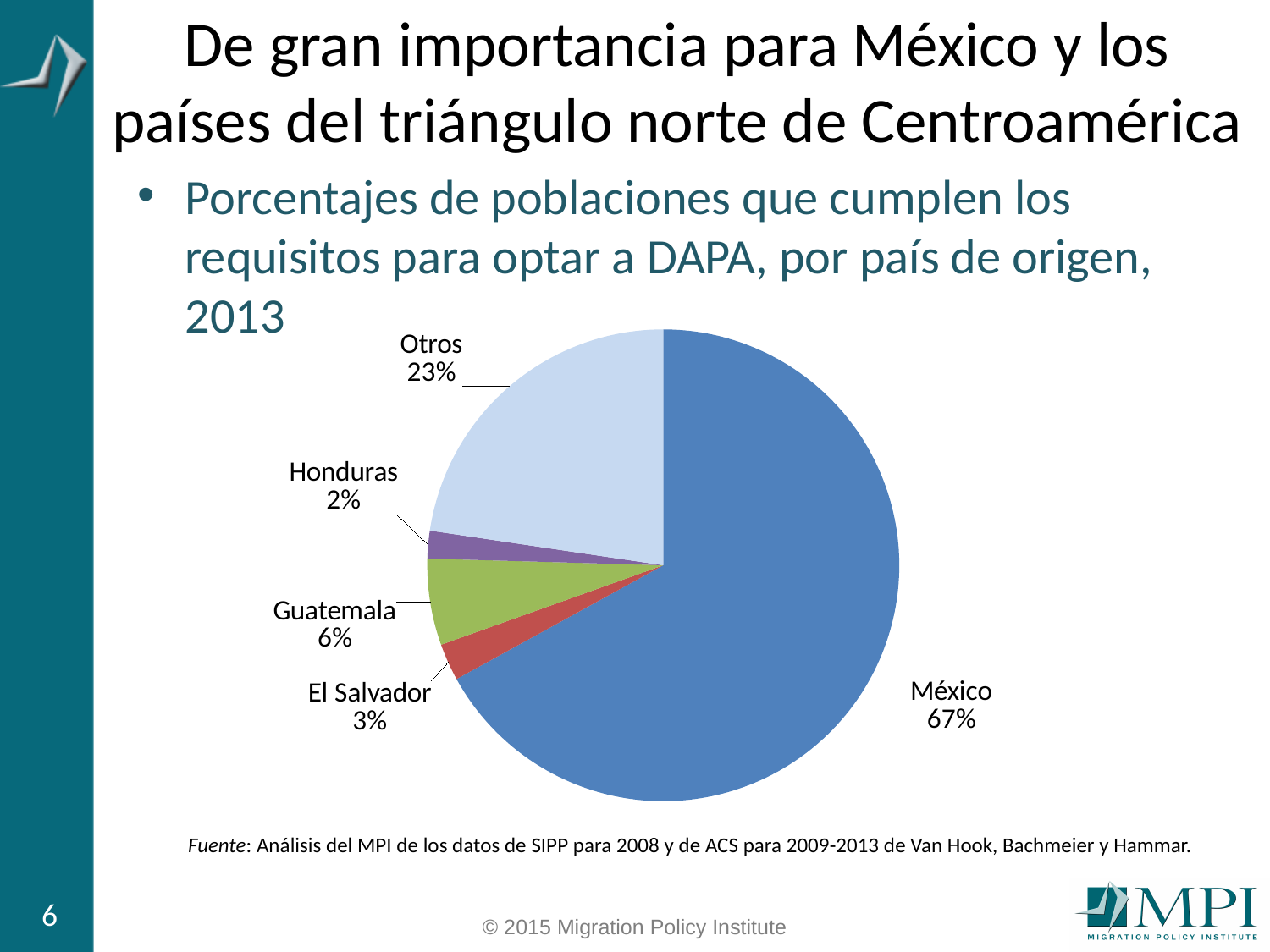
What kind of chart is shown on the slide? pie chart What is the value shown for Guatemala? 6% What is the value shown for Honduras? 2% Which is larger, the value for Guatemala or the value for El Salvador? Guatemala What is the combined share of Guatemala, El Salvador and Honduras? 11% What is the difference between the values for México and Otros? 44% What is the value shown for El Salvador? 3% What is the value shown for Otros? 23% How many slices does the pie chart have? 5 Which category has the largest slice of the pie? México Which category has the smallest slice of the pie? Honduras What share of the pie does México account for? 67%